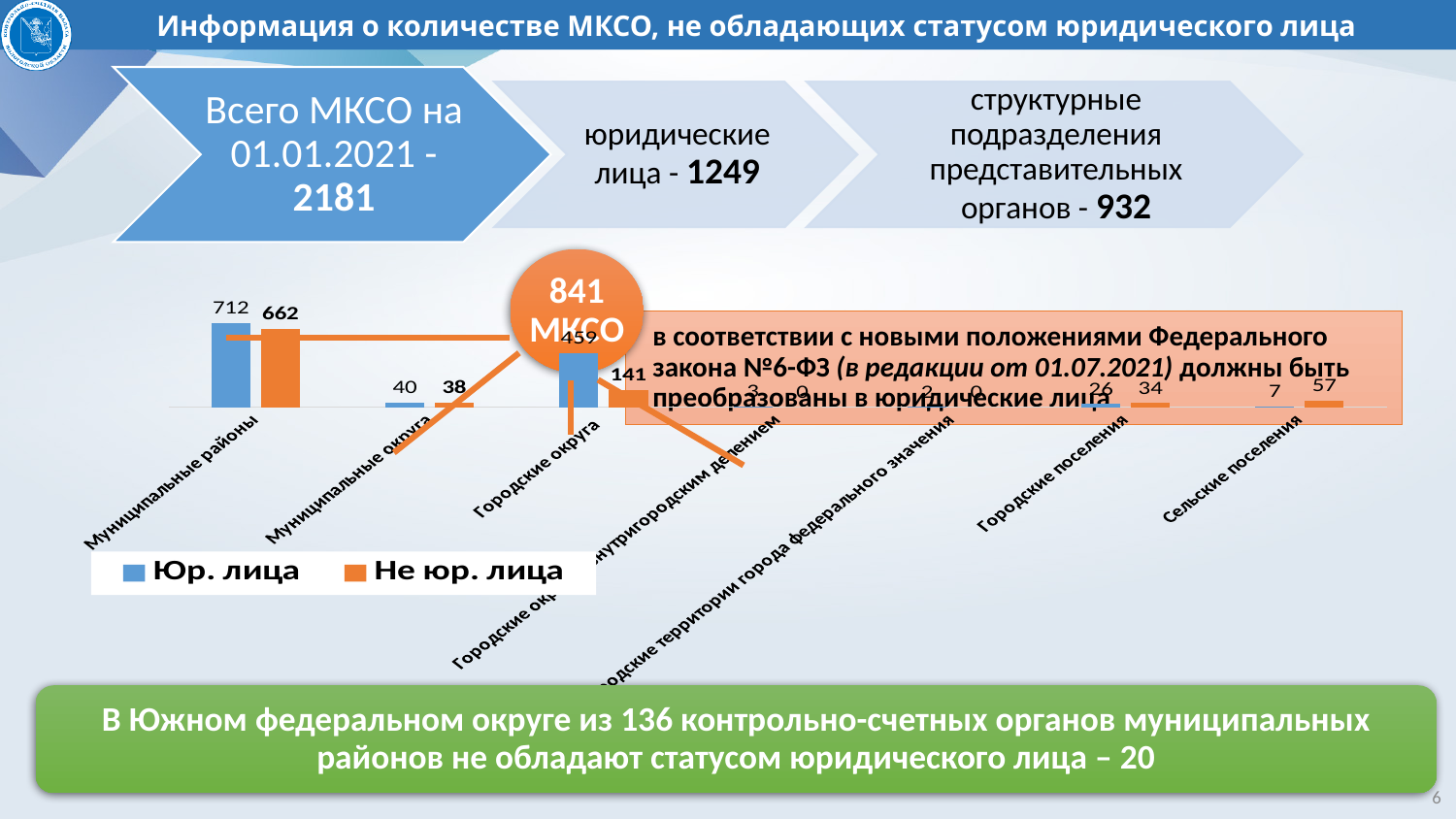
What is the value of Не юр. лица for Городские поселения? 34 What is the value of Не юр. лица for Муниципальные районы? 662 What kind of chart is shown on the slide? Bar chart What is the value of Юр. лица for Муниципальные округа? 40 What is the value of Юр. лица for Городские округа? 459 What is the difference between Юр. лица and Не юр. лица for Муниципальные районы? 50 What is the value of Юр. лица for Муниципальные районы? 712 Which category has the highest value for Юр. лица? Муниципальные районы How many series does the chart legend list? 2 What is the value of Не юр. лица for Сельские поселения? 57 What is the difference between Юр. лица and Не юр. лица for Городские округа? 318 For Сельские поселения, which series is larger: Юр. лица or Не юр. лица? Не юр. лица